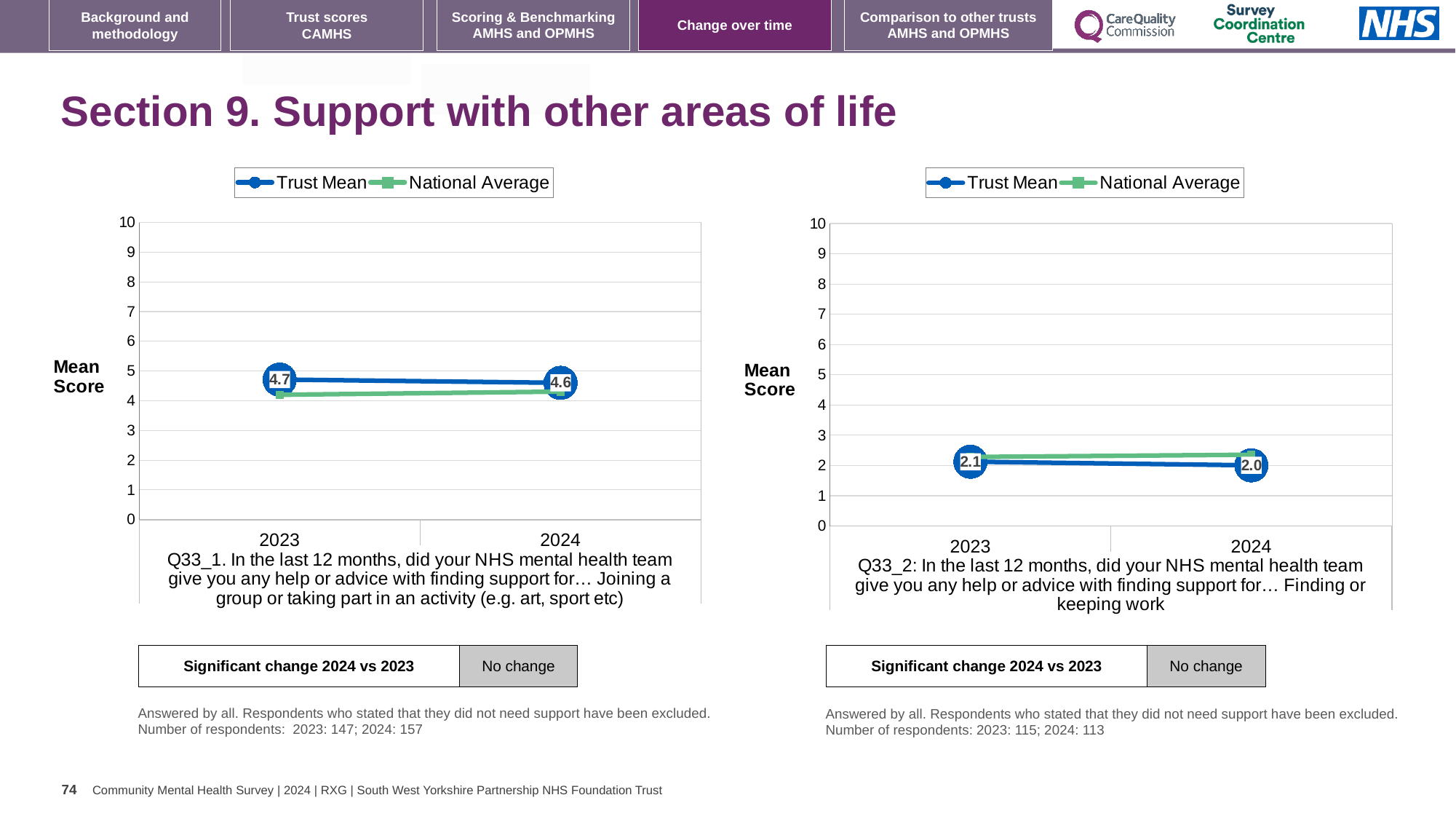
On the left chart (Q33_1), what is the difference between the Trust Mean in 2023 and in 2024? 0.1 On the left chart (Q33_1), what is the Trust Mean for 2023? 4.7 On the right chart (Q33_2), is the National Average for 2024 greater or less than 3? less How many series does the legend of the left chart (Q33_1) list? 2 On the right chart (Q33_2), what is the Trust Mean for 2024? 2.0 On the left chart (Q33_1), what is the Trust Mean for 2024? 4.6 On the left chart (Q33_1), is the National Average for 2023 greater or less than 5? less What kind of chart is the left chart (Q33_1)? Line chart On the left chart (Q33_1), does the Trust Mean rise or fall from 2023 to 2024? Fall On the right chart (Q33_2), which year has the higher Trust Mean, 2023 or 2024? 2023 On the right chart (Q33_2), what is the Trust Mean for 2023? 2.1 How many years are plotted on the x axis of the right chart (Q33_2)? 2